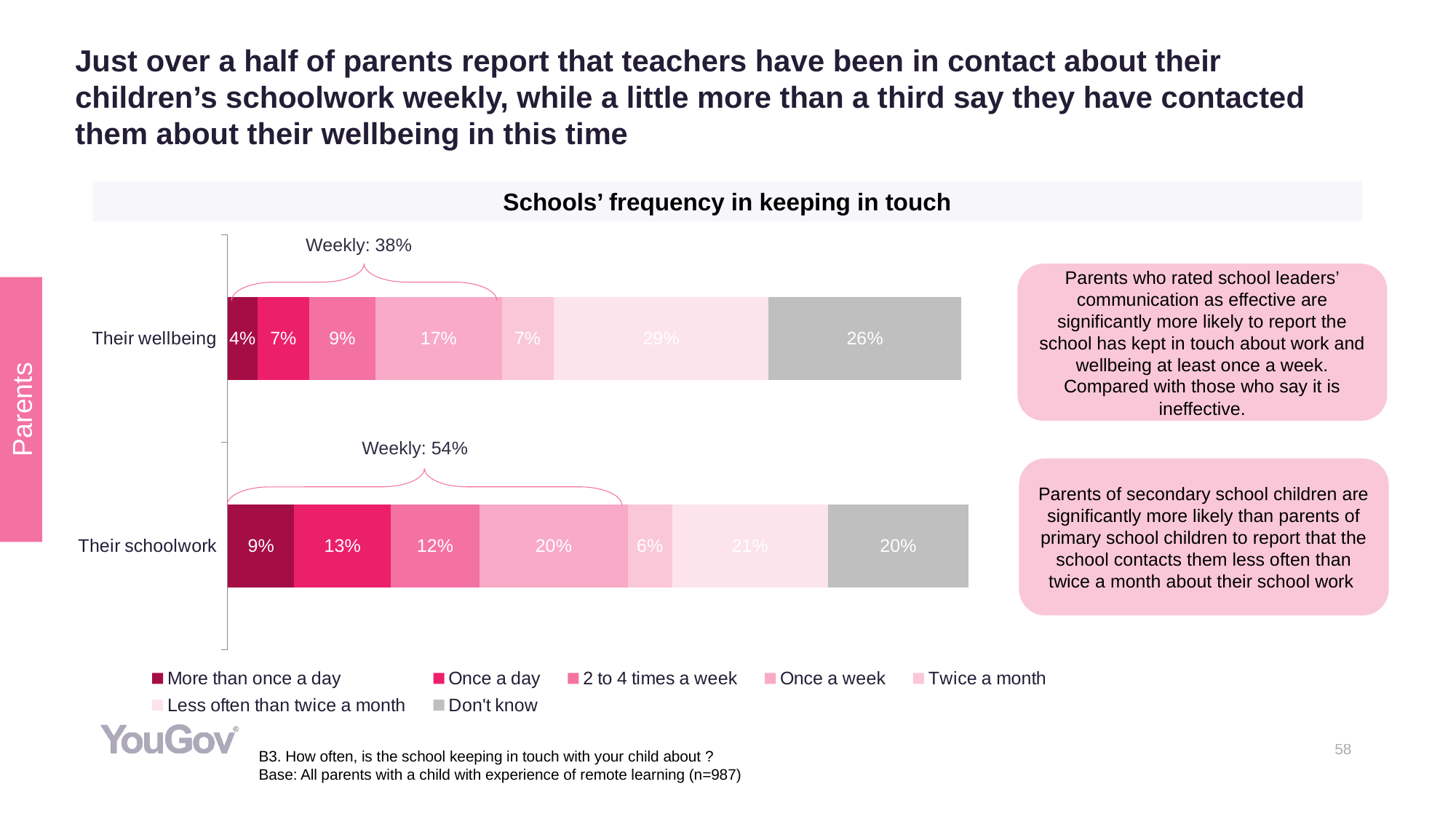
Which segment is the largest in the "Their wellbeing" bar? Less often than twice a month What is the difference between the "More than once a day" values for their schoolwork and their wellbeing? 5% What percentage of parents say the school keeps in touch about their schoolwork once a day? 13% What weekly total is annotated above the "Their schoolwork" bar? Weekly: 54% What percentage of parents answered "Don't know" for their wellbeing? 26% How many categories (bars) does the chart show? 2 Which segment is the smallest in the "Their wellbeing" bar? More than once a day What is the "Less often than twice a month" value for their wellbeing? 29% Which is larger: the "2 to 4 times a week" value for their schoolwork or for their wellbeing? Their schoolwork What kind of chart is shown under the title "Schools' frequency in keeping in touch"? Stacked bar chart What is the "Once a week" value for their schoolwork? 20% How many series does the legend list? 7